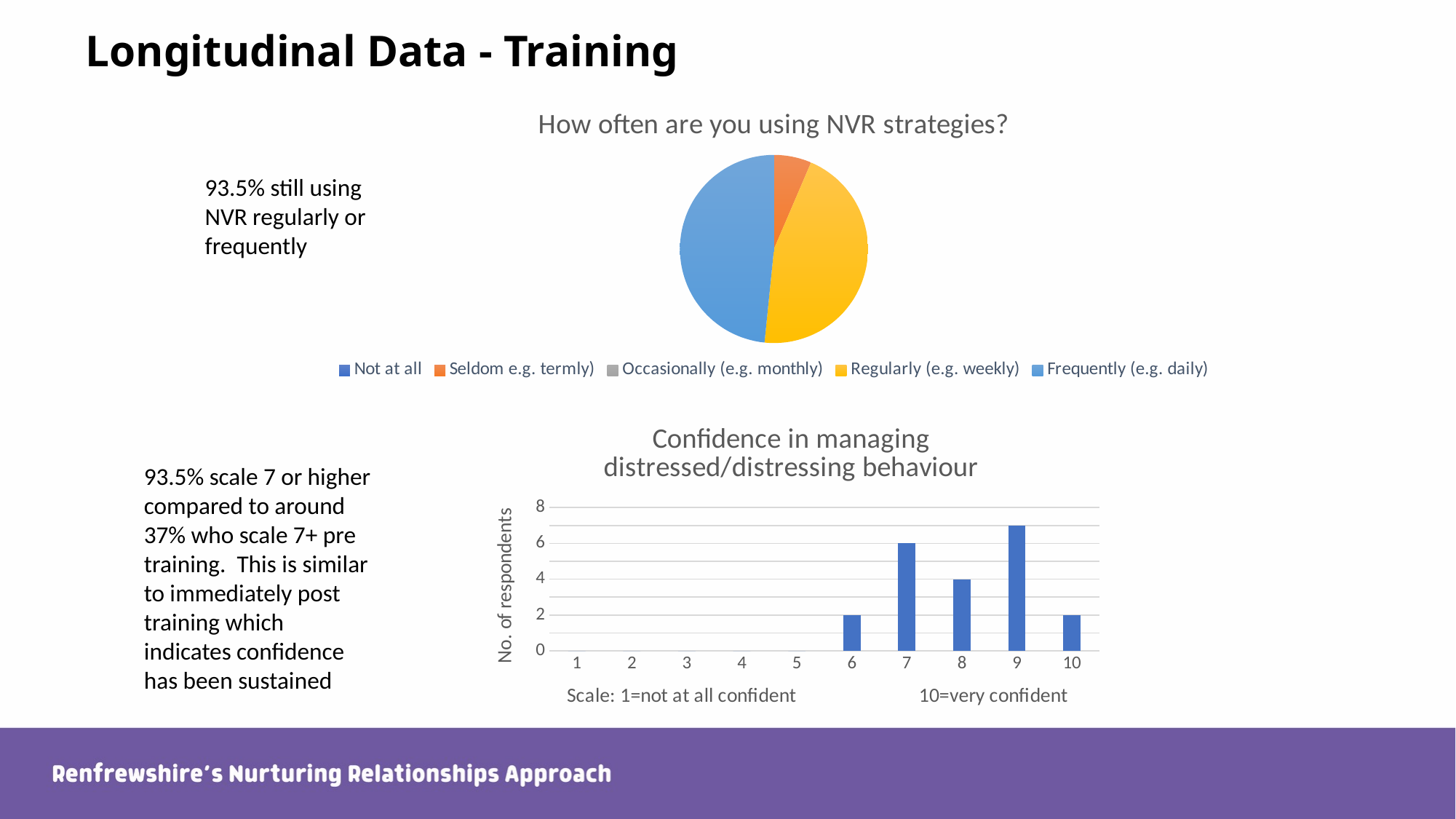
In the "Confidence in managing distressed/distressing behaviour" chart, which scale score has the highest number of respondents? 9 In the "Confidence in managing distressed/distressing behaviour" chart, which has more respondents, score 7 or score 8? 7 How many scale categories are shown on the x axis of the "Confidence in managing distressed/distressing behaviour" chart? 10 What type of chart is the "Confidence in managing distressed/distressing behaviour" chart? Bar chart In the "How often are you using NVR strategies?" pie chart, which visible category has the smallest slice? Seldom e.g. termly) How many entries does the legend of the "How often are you using NVR strategies?" chart list? 5 In the "Confidence in managing distressed/distressing behaviour" chart, how many respondents gave a score of 8? 4 In the "Confidence in managing distressed/distressing behaviour" chart, what is the difference between the number of respondents for score 7 and score 8? 2 In the "Confidence in managing distressed/distressing behaviour" chart, how many respondents gave a score of 10? 2 What type of chart is the chart titled "How often are you using NVR strategies?"? Pie chart In the "Confidence in managing distressed/distressing behaviour" chart, how many respondents gave a score of 7? 6 In the "Confidence in managing distressed/distressing behaviour" chart, is the number of respondents for score 9 greater or less than 6? greater